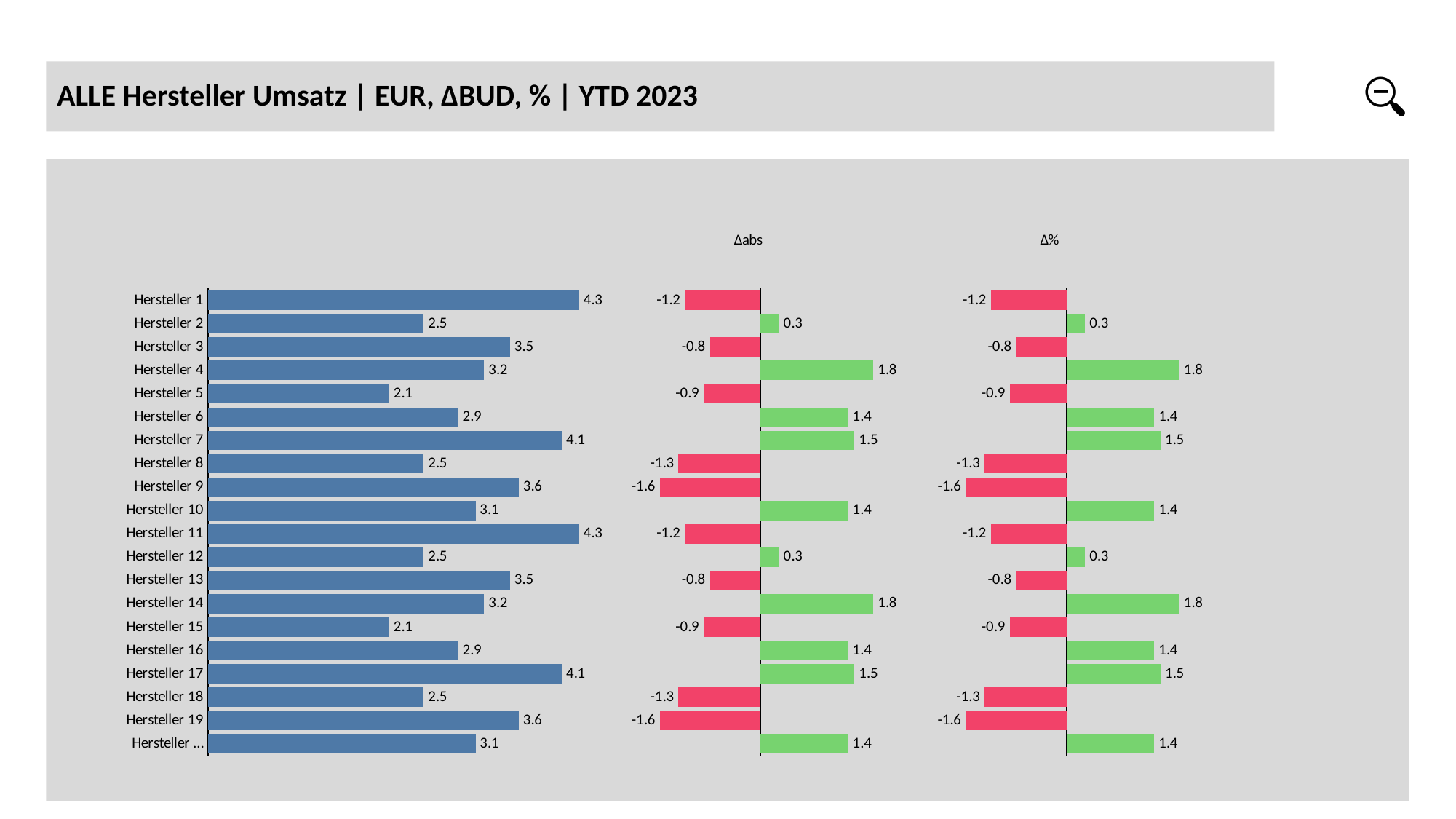
In the left chart, what is the highest value shown? 4.3 In the left chart, which is larger, the value for Hersteller 3 or Hersteller 4? Hersteller 3 In the Δ% chart, what is the value for Hersteller 14? 1.8 What kind of chart is used on this slide? bar chart In the left chart, what is the value for Hersteller 7? 4.1 How many bars are shown in the left chart? 20 In the Δabs chart, what is the value for Hersteller 9? -1.6 In the left chart, what is the value for Hersteller 5? 2.1 In the Δabs chart, what is the lowest value shown? -1.6 In the left chart, what is the difference between the values for Hersteller 1 and Hersteller 2? 1.8 In the Δabs chart, what is the difference between the values for Hersteller 4 and Hersteller 6? 0.4 What is the title of the slide? ALLE Hersteller Umsatz | EUR, ΔBUD, % | YTD 2023